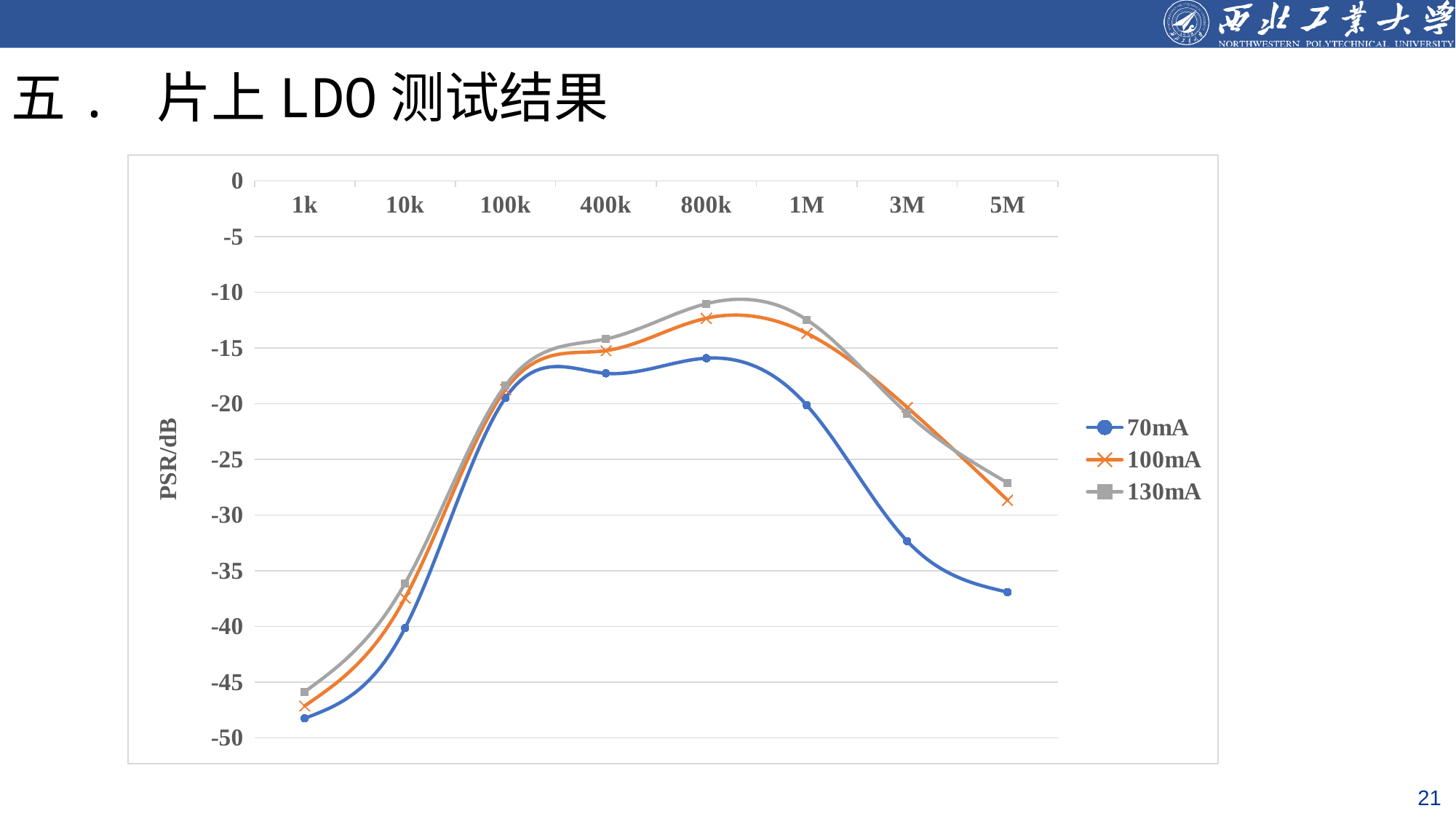
At 5M, which series has the larger value, 70mA or 100mA? 100mA At which frequency does the 70mA series reach its highest value? 800k Is the value for 70mA at 3M greater or less than -30? less Is the value for 130mA at 800k greater or less than -15? greater How many series does the legend list? 3 What is the label of the y axis? PSR/dB At which frequency does the 70mA series have its lowest value? 1k Does the 70mA series rise or fall from 800k to 5M? fall How many frequency points are plotted along the x axis? 8 What kind of chart is shown on the slide? line chart Is the value for 70mA at 1k greater or less than -45? less Which series is drawn with x-shaped markers? 100mA